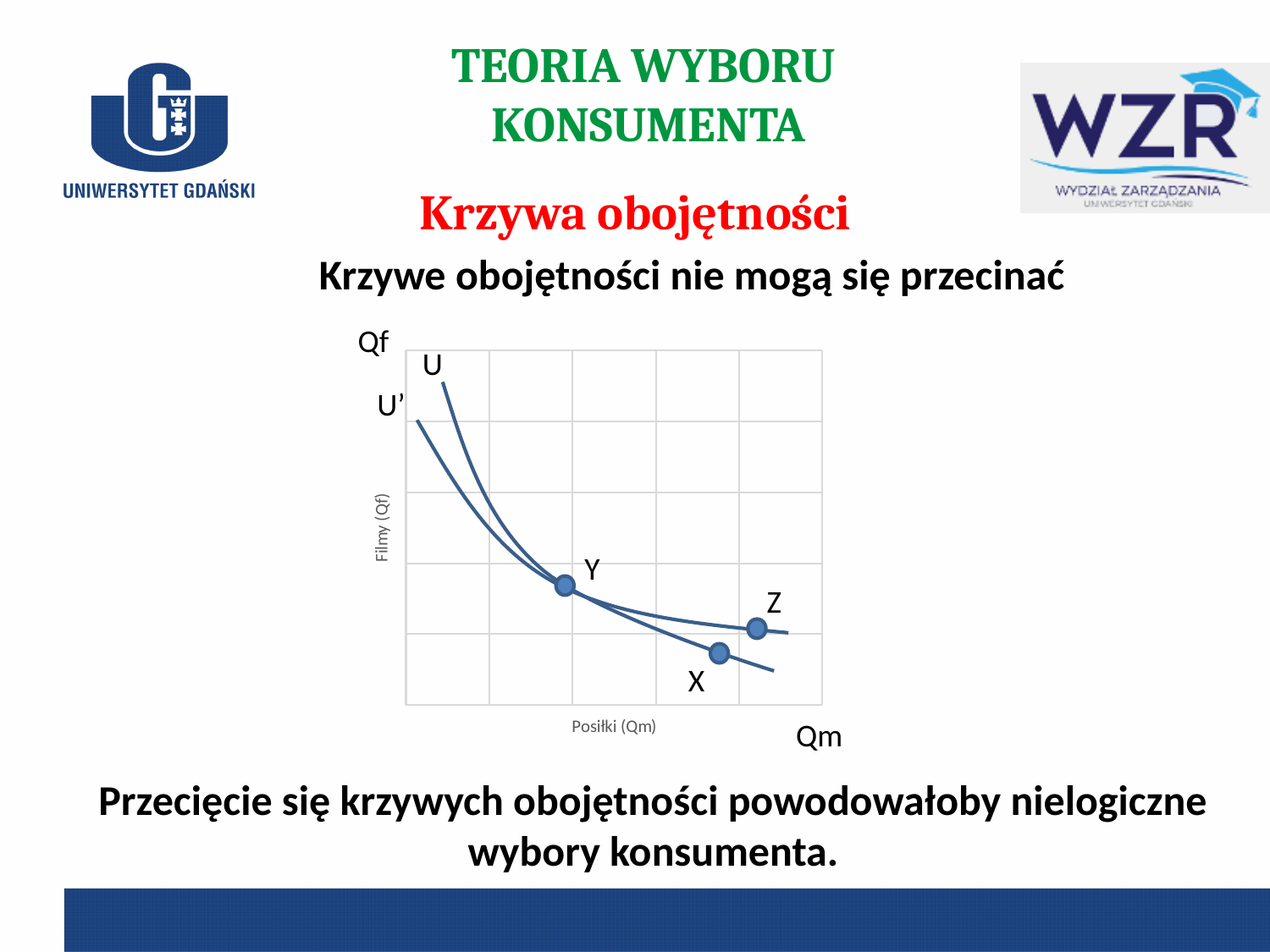
Do the curves rise or fall as Qm increases along the x axis? fall Which point has the larger Qm value, Y or X? X What is the label of the horizontal axis of the chart? Posiłki (Qm) How many labelled points are marked on the curves? 3 Which of the marked points X, Y and Z has the highest value on the Qf axis? Y Which of the marked points X, Y and Z lies furthest to the right on the Qm axis? Z Which point has the larger Qf value, X or Z? Z How many curves are plotted on the chart? 2 Which of the marked points X, Y and Z lies furthest to the left on the Qm axis? Y What kind of chart is shown on the slide? line chart Which of the marked points X, Y and Z has the lowest value on the Qf axis? X What are the labels of the two curves on the chart? U and U'